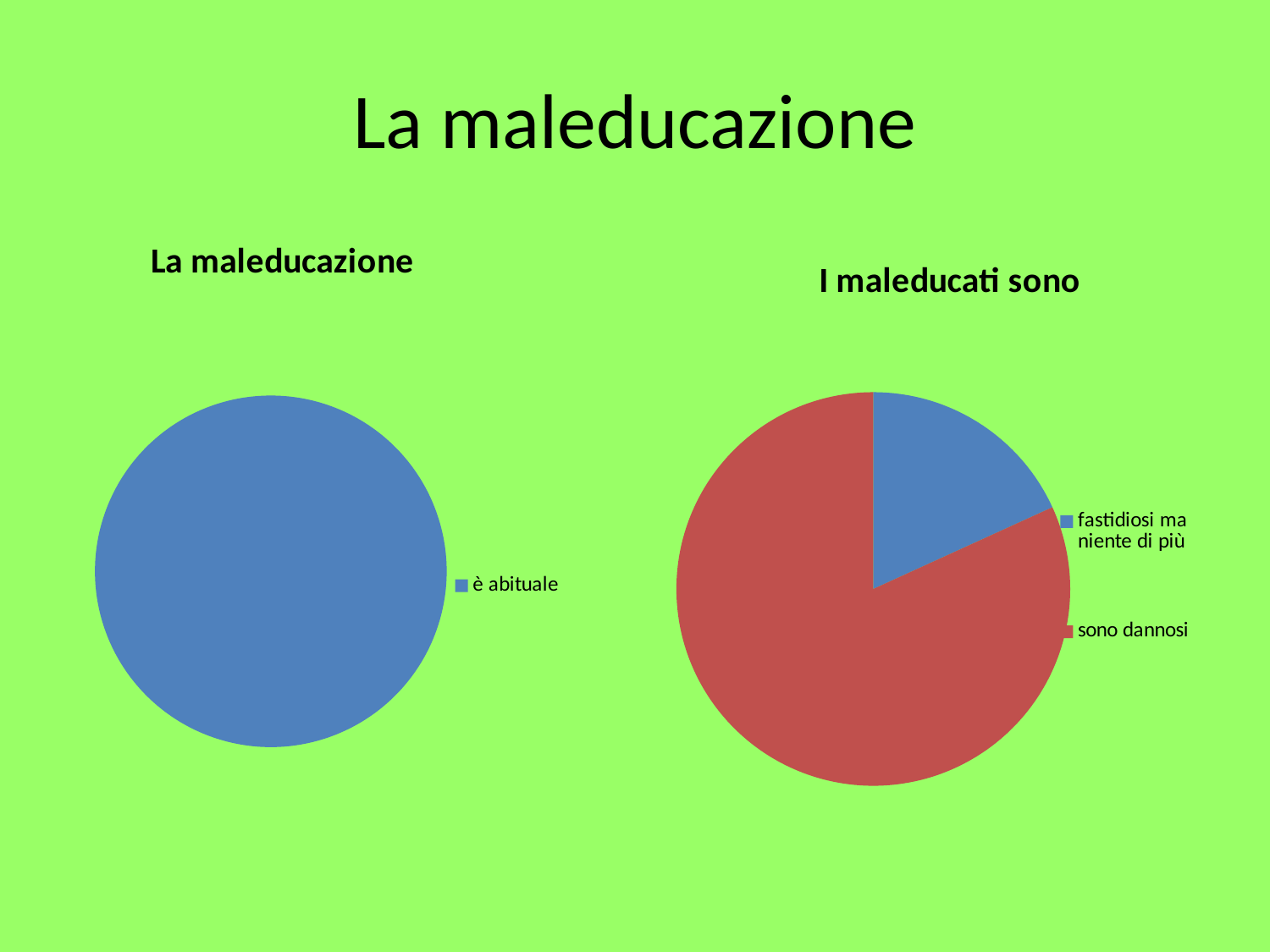
How many slices does the chart titled "I maleducati sono" have? 2 In the chart titled "I maleducati sono", what colour is the slice for "sono dannosi"? red In the chart titled "I maleducati sono", which category has the largest slice? sono dannosi In the chart titled "I maleducati sono", which category has the smallest slice? fastidiosi ma niente di più What kind of chart is the chart titled "I maleducati sono"? pie chart What kind of chart is the chart titled "La maleducazione" on the left of the slide? pie chart How many entries does the legend of the chart titled "I maleducati sono" list? 2 How many slices does the chart titled "La maleducazione" on the left of the slide have? 1 In the chart titled "I maleducati sono", which slice is larger: "sono dannosi" or "fastidiosi ma niente di più"? sono dannosi What is the only legend entry of the chart titled "La maleducazione" on the left of the slide? è abituale How many entries does the legend of the chart titled "La maleducazione" on the left of the slide list? 1